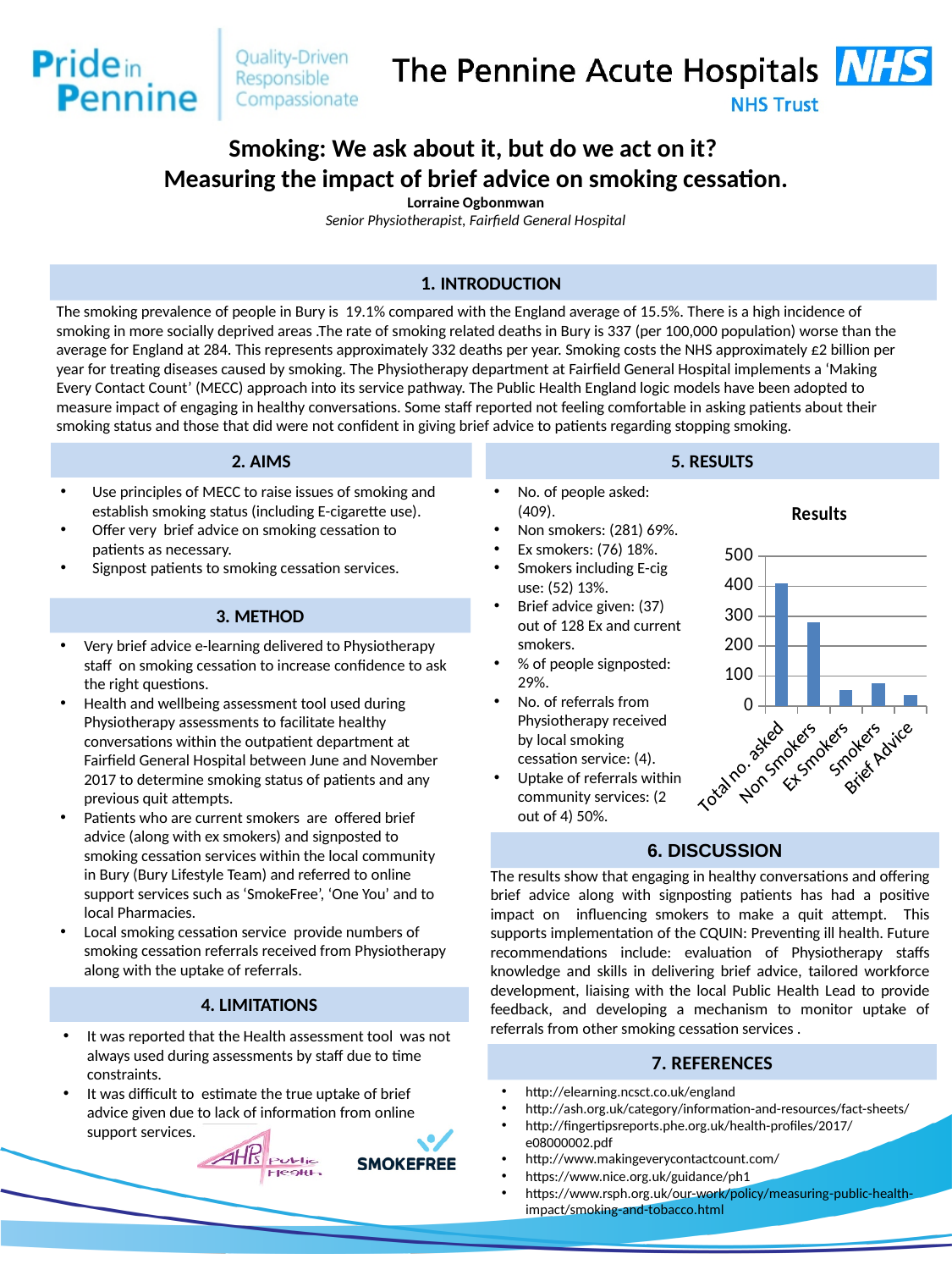
On the Results chart, is the value for Brief Advice greater or less than 100? less Which category has the lowest bar on the Results chart? Brief Advice On the Results chart, which bar is taller: Ex Smokers or Smokers? Smokers Do the bar values on the Results chart generally rise or fall from left to right? fall On the Results chart, is the value for Total no. asked greater or less than 300? greater What kind of chart is shown under the Results heading? bar chart On the Results chart, is the value for Non Smokers greater or less than 200? greater On the Results chart, which bar is taller: Non Smokers or Ex Smokers? Non Smokers How many categories are plotted on the Results chart? 5 What is the title of the chart in the Results section? Results Which category has the highest bar on the Results chart? Total no. asked